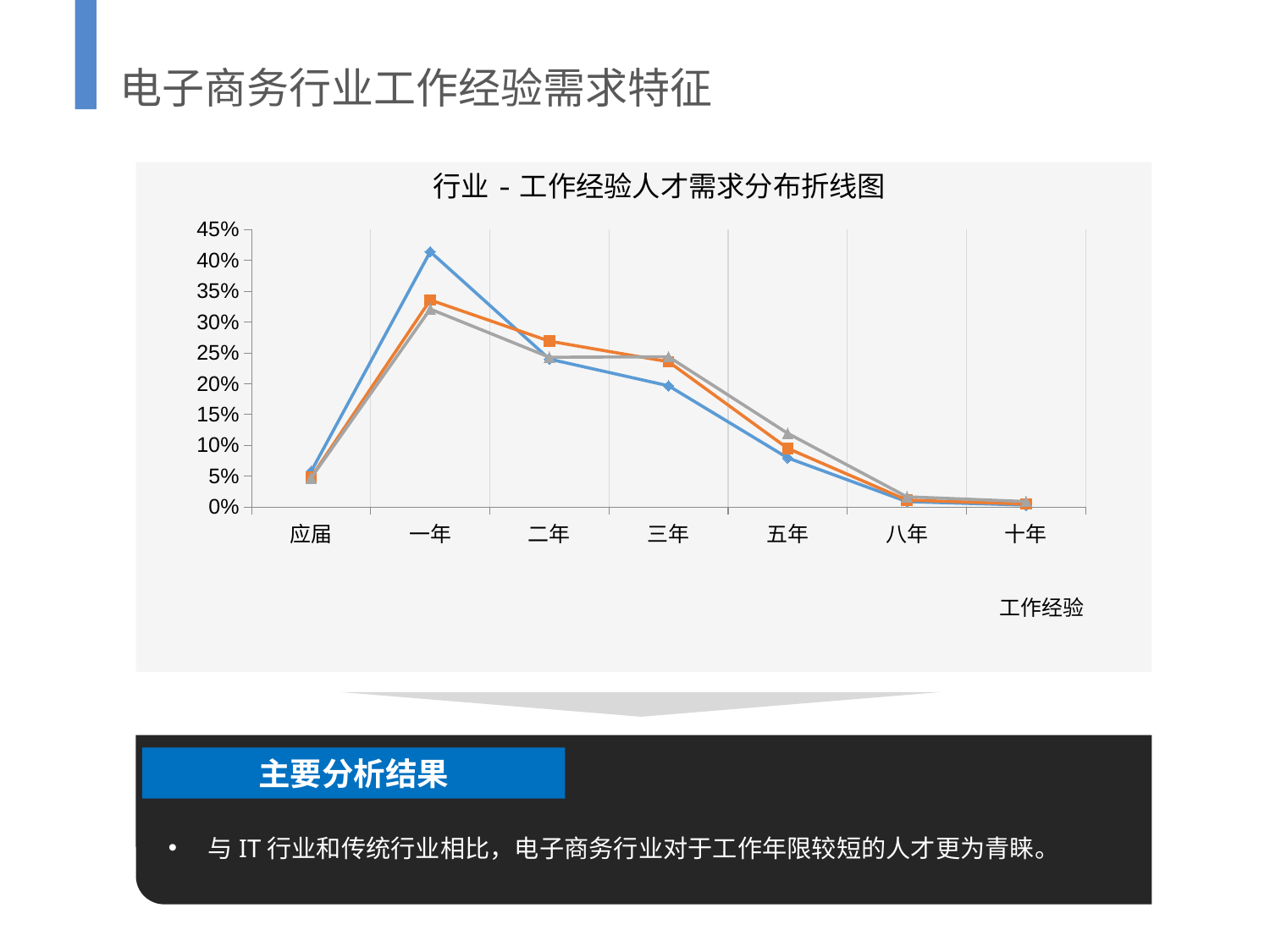
What is the title of the chart? 行业 - 工作经验人才需求分布折线图 Is the value of the orange line at 二年 greater or less than 25%? greater What kind of chart is shown on the slide? line chart How many work-experience categories are shown on the x axis? 7 Is the value of the blue line at 一年 greater or less than 35%? greater Is the value of the blue line at 三年 greater or less than 25%? less At which work-experience category does the orange line reach its lowest value? 十年 At 一年, which line has the higher value, the blue line or the orange line? the blue line What is the label of the x axis? 工作经验 At which work-experience category does the blue line reach its highest value? 一年 Do the values of the blue line rise or fall from 一年 to 十年? fall